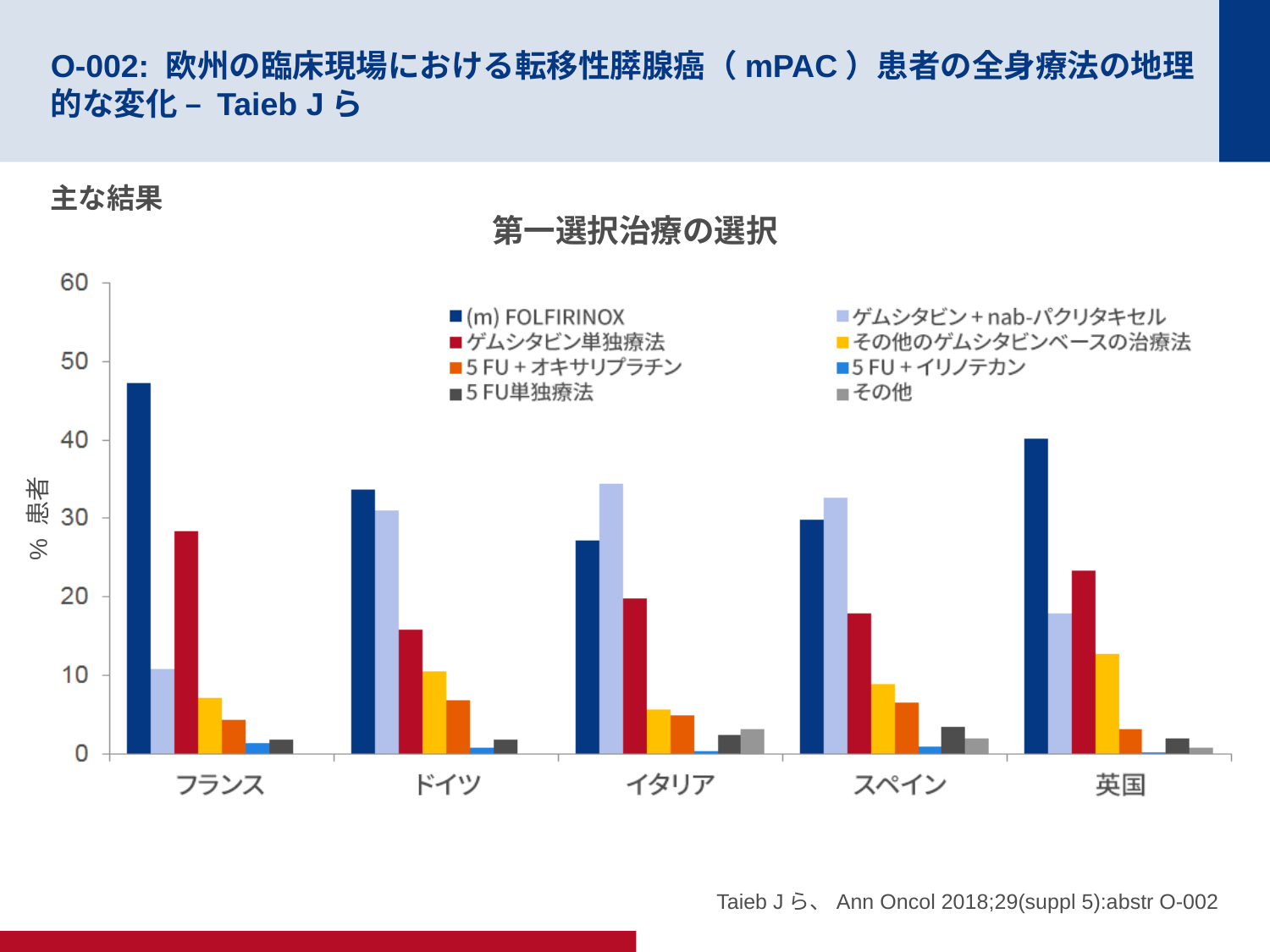
Which country has the lowest value for (m) FOLFIRINOX? イタリア Is the value for ゲムシタビン + nab-パクリタキセル in イタリア greater or less than 30? greater How many series does the legend of the chart list? 8 Is the value for ゲムシタビン単独療法 in 英国 greater or less than 20? greater Is the value for (m) FOLFIRINOX in フランス greater or less than 40? greater How many countries are shown on the x axis of the chart? 5 Which country has the highest value for (m) FOLFIRINOX? フランス In イタリア, which is larger: (m) FOLFIRINOX or ゲムシタビン + nab-パクリタキセル? ゲムシタビン + nab-パクリタキセル What kind of chart is shown on the slide? bar chart What is the title of the chart? 第一選択治療の選択 Which is larger: ゲムシタビン単独療法 in フランス or ゲムシタビン単独療法 in 英国? フランス